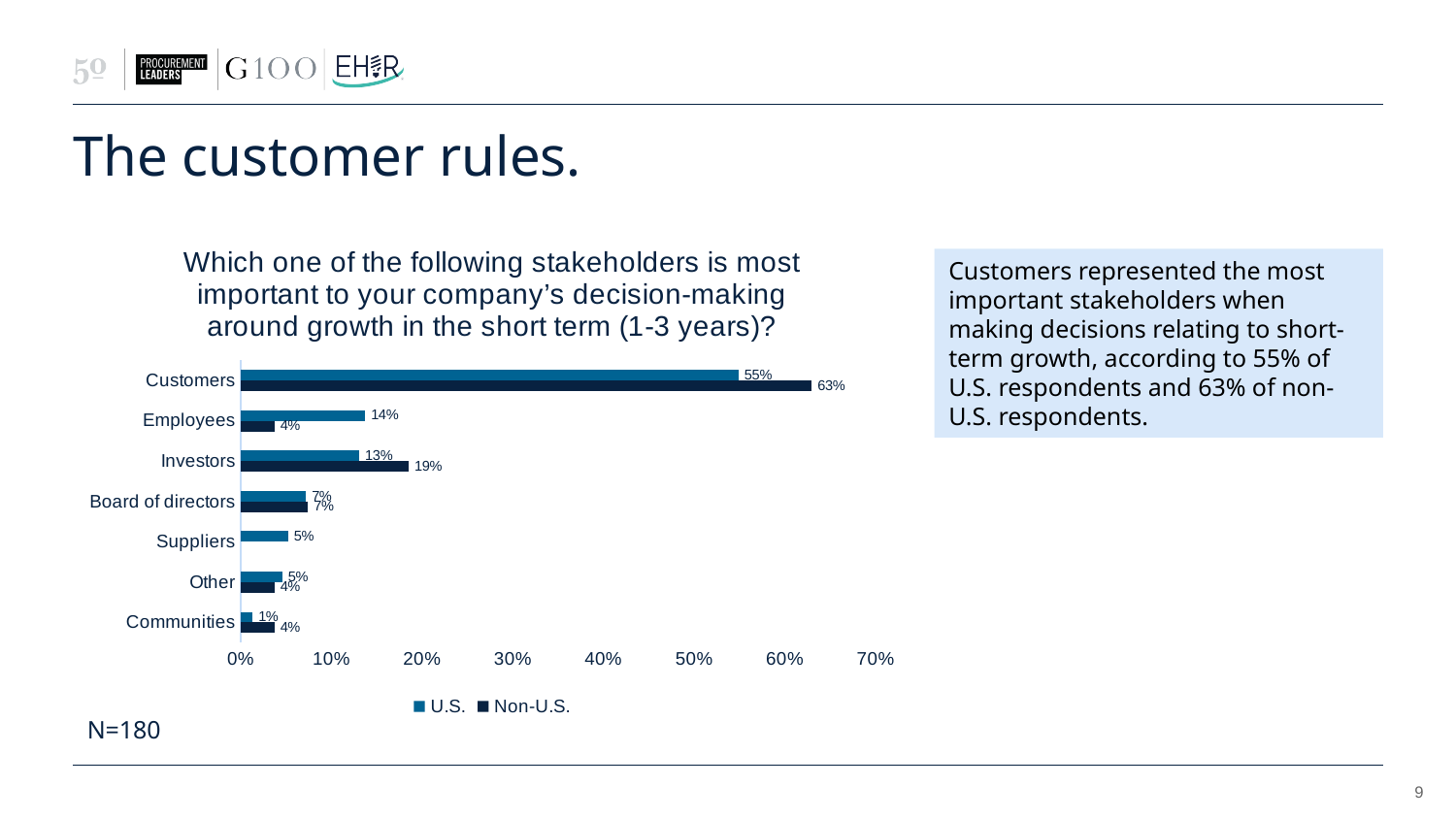
How many stakeholder categories are shown on the chart? 7 What percentage of Non-U.S. respondents chose Customers? 63% What percentage of U.S. respondents chose Customers as the most important stakeholder? 55% What type of chart is shown on the slide? Bar chart How many series does the legend list? 2 Which stakeholder has the highest value for Non-U.S. respondents? Customers What is the U.S. value for Employees? 14% For Investors, which is larger: the U.S. value or the Non-U.S. value? Non-U.S. Which stakeholder has the lowest value for U.S. respondents? Communities What is the Non-U.S. value for Investors? 19% What is the difference between the Non-U.S. and U.S. values for Customers? 8% What is the difference between the U.S. and Non-U.S. values for Employees? 10%